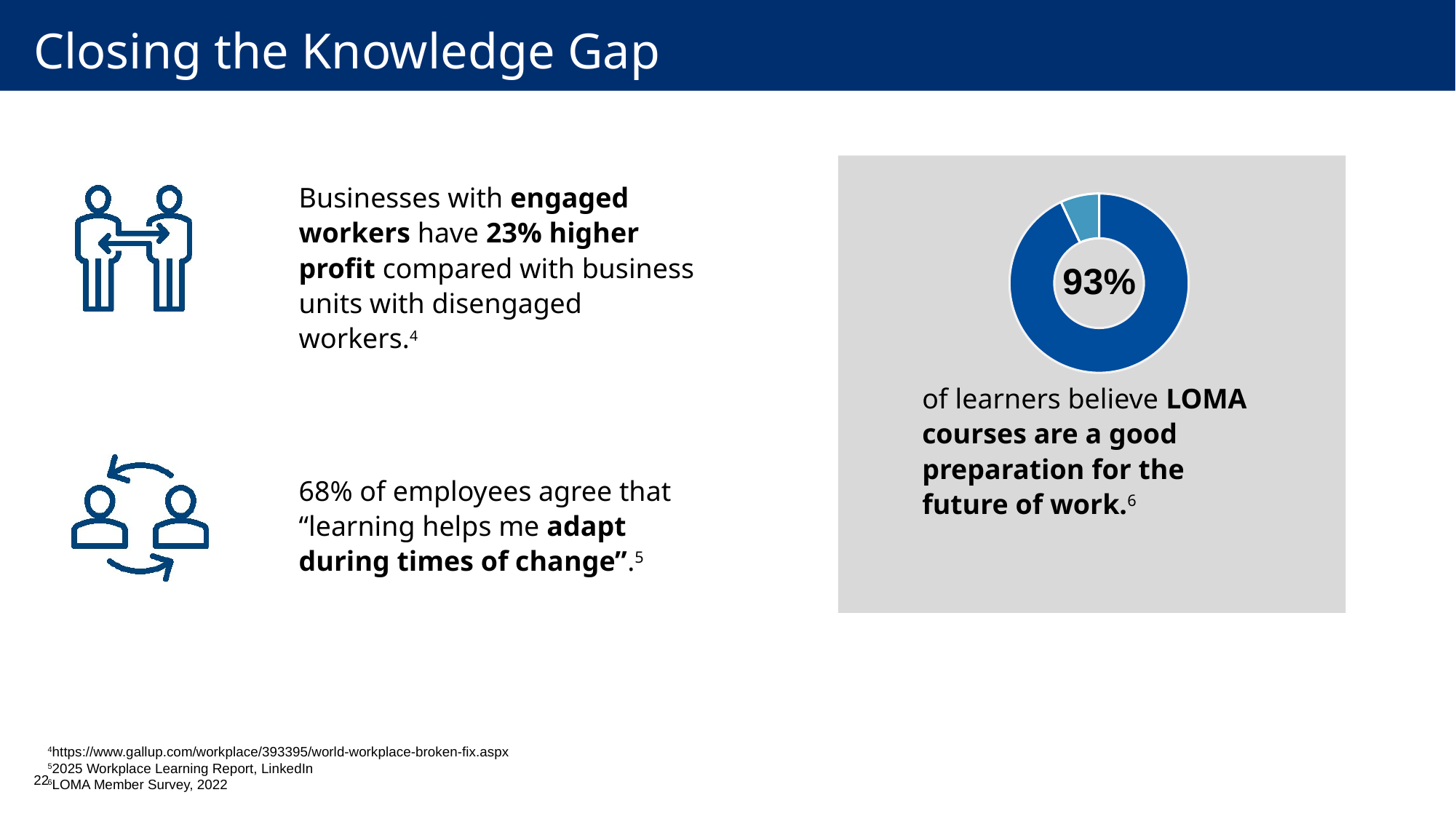
Is the share represented by the dark blue slice of the donut chart greater or less than 50%? greater Is the share represented by the light blue slice of the donut chart greater or less than 25%? less Which slice of the donut chart is larger, the dark blue one or the light blue one? The dark blue one What is the source cited for the donut chart's 93% figure? LOMA Member Survey, 2022 What kind of chart is shown on the right side of the slide? Donut chart What percentage is printed in the centre of the donut chart? 93% How many slices does the donut chart have? 2 What colour is the largest slice of the donut chart? Dark blue According to the donut chart, what share of learners believe LOMA courses are a good preparation for the future of work? 93%